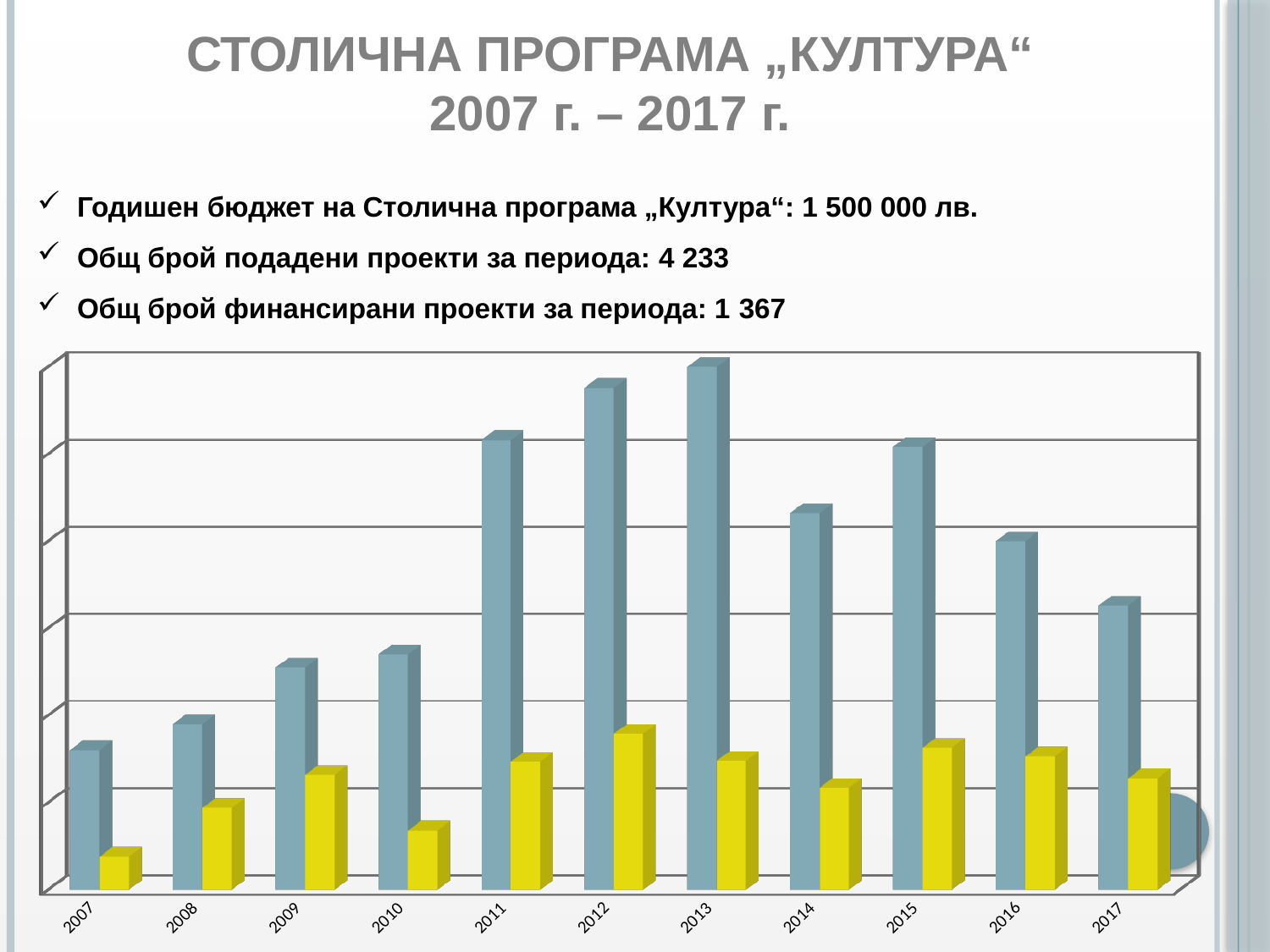
What kind of chart is shown on the slide? bar chart Is the yellow bar for 2010 taller or shorter than the yellow bar for 2009? shorter Is the blue bar for 2012 taller or shorter than the blue bar for 2015? taller What two colours are used for the bars in the chart? blue and yellow Do the blue bars rise or fall from 2007 to 2013? rise Which year has the tallest yellow bar in the chart? 2012 How many bars are plotted for each year in the chart? 2 Which year has the shortest yellow bar in the chart? 2007 Which year has the shortest blue bar in the chart? 2007 Do the blue bars rise or fall from 2015 to 2017? fall How many years are shown on the x axis of the chart? 11 Which year has the tallest blue bar in the chart? 2013